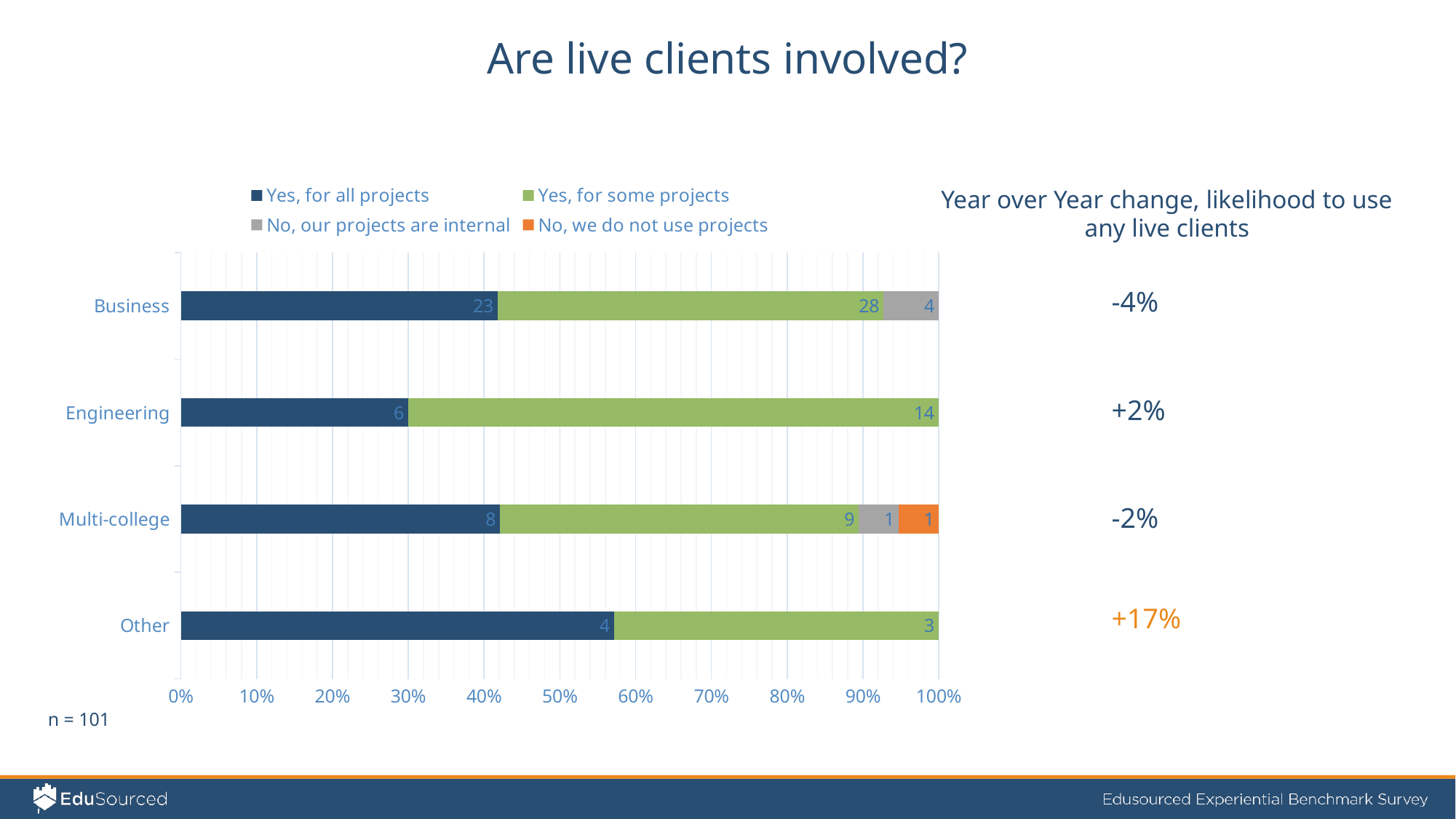
How many categories are shown on the vertical axis of the chart? 4 What is the total of the stacked bar for Business? 55 How many series does the legend list? 4 What is the value for "No, our projects are internal" in the Business category? 4 What is the value for "Yes, for some projects" in the Engineering category? 14 Which category has the highest value for "Yes, for all projects"? Business What is the difference between the "Yes, for some projects" value and the "Yes, for all projects" value for Business? 5 What is the value for "Yes, for all projects" in the Business category? 23 What is the total of the stacked bar for Multi-college? 19 What kind of chart is shown on the slide? Stacked bar chart What is the value for "No, we do not use projects" in the Multi-college category? 1 Which category has the lowest value for "Yes, for some projects"? Other